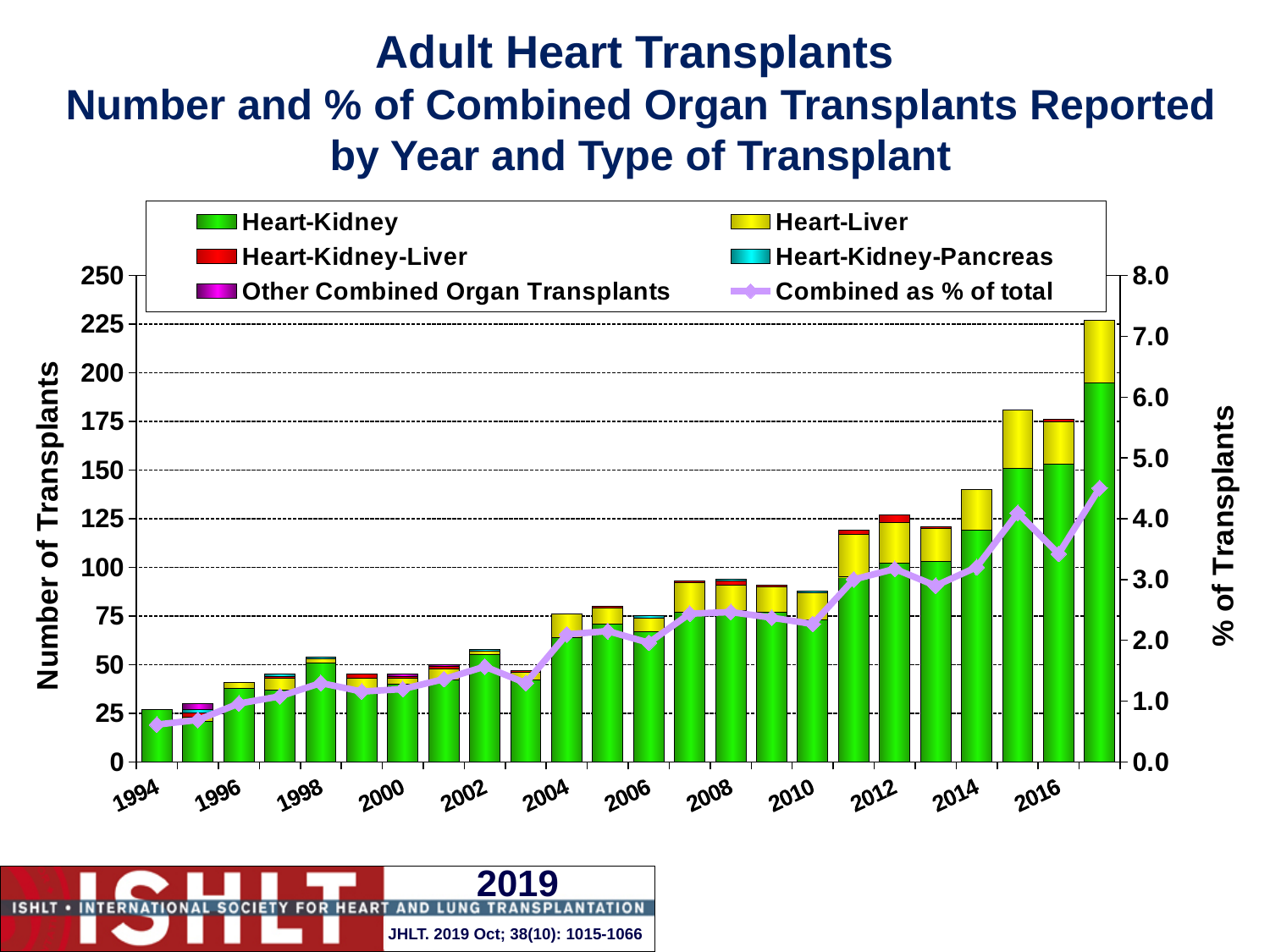
Is the total number of transplants for 1994 greater or less than 50? less How many series does the legend list? 6 Is the 'Combined as % of total' value for 2016 greater or less than 3.0? greater Is the total number of transplants for 2010 greater or less than 100? less Which year has the taller bar, 2014 or 2016? 2016 Which legend series is shown in green? Heart-Kidney Do the total numbers of transplants generally rise or fall from 1994 to 2016? rise Which year labeled on the x axis has the shortest bar for number of transplants? 1994 What kind of chart is shown on the slide? combination bar and line chart How many yearly bars are plotted in the chart? 24